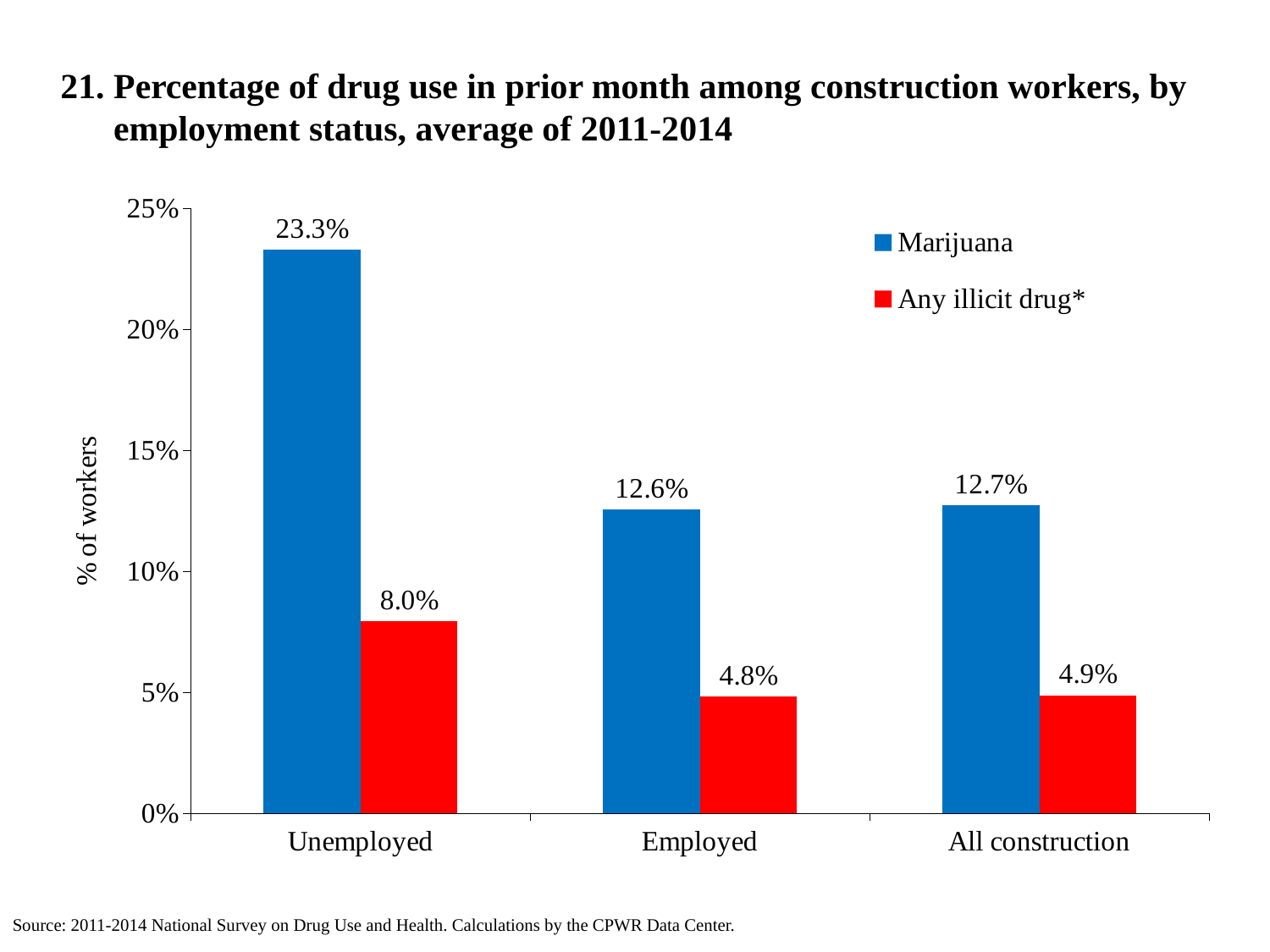
How many series does the legend list? 2 What is the difference between the Marijuana and Any illicit drug* values for Unemployed workers? 15.3% What is the difference between the Marijuana values for Unemployed and Employed workers? 10.7% Is the Marijuana value for Unemployed workers greater or less than 20%? greater What kind of chart is shown on the slide? Bar chart Which employment status category has the highest Marijuana value? Unemployed Which employment status category has the lowest Any illicit drug* value? Employed What is the Any illicit drug* value for Employed workers? 4.8% What is the Marijuana value for Unemployed workers? 23.3% What is the Any illicit drug* value for All construction? 4.9% How many employment status categories are shown on the x axis? 3 Which is larger for Employed workers: the Marijuana value or the Any illicit drug* value? Marijuana